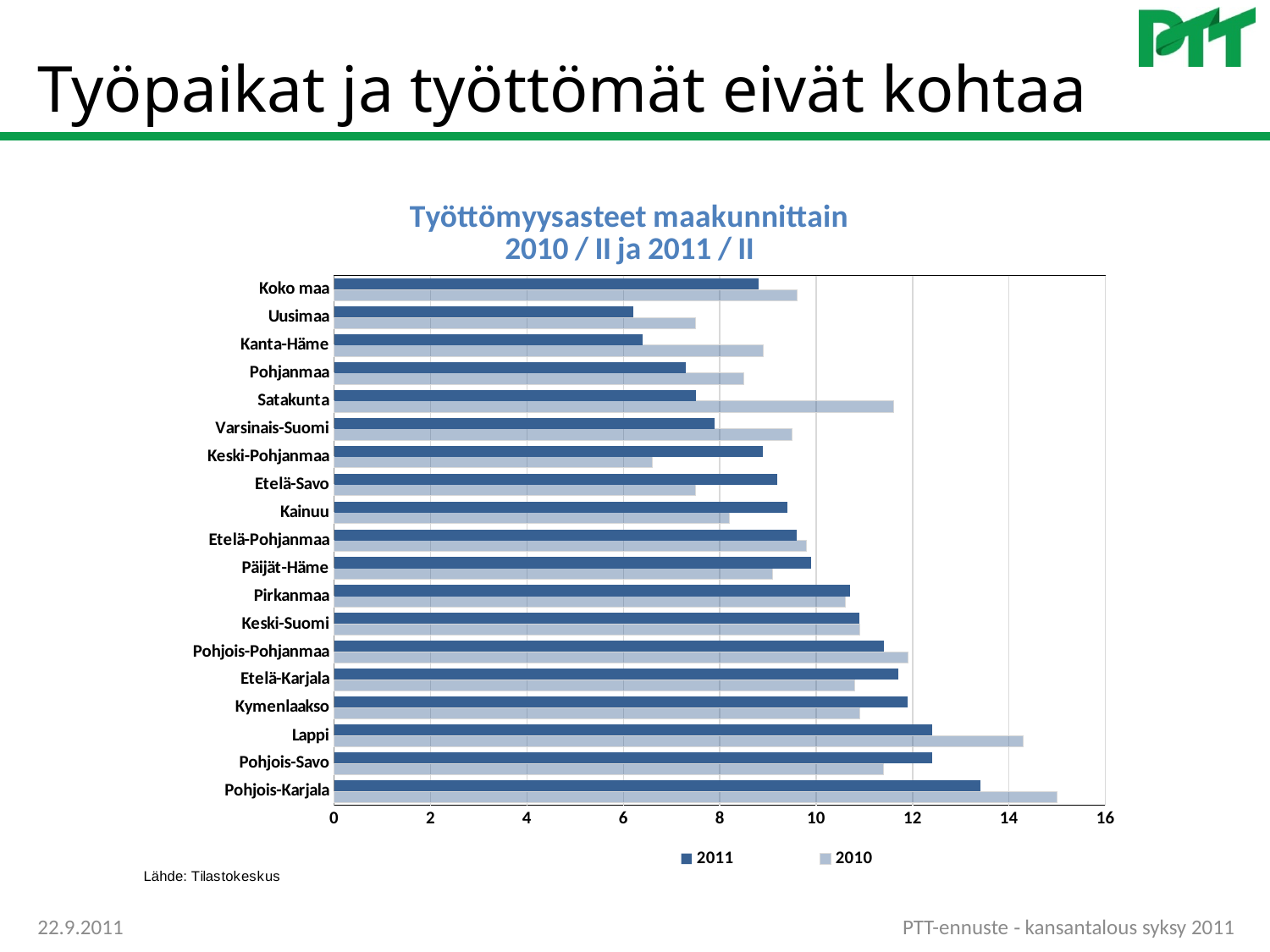
How many regions (categories) are plotted on the chart? 19 Which region has the lowest unemployment rate for 2011? Uusimaa For Keski-Pohjanmaa, which year has the larger value, 2010 or 2011? 2011 Is the 2011 value for Koko maa greater or less than 10? less Which region has the highest unemployment rate for 2011? Pohjois-Karjala For Satakunta, which year has the larger value, 2010 or 2011? 2010 How many series does the legend list? 2 What is the title of the chart? Työttömyysasteet maakunnittain 2010 / II ja 2011 / II Which region has the lowest unemployment rate for 2010? Keski-Pohjanmaa Is the 2010 value for Lappi greater or less than 14? greater Is the 2010 value for Satakunta greater or less than 10? greater What kind of chart is shown on the slide? bar chart